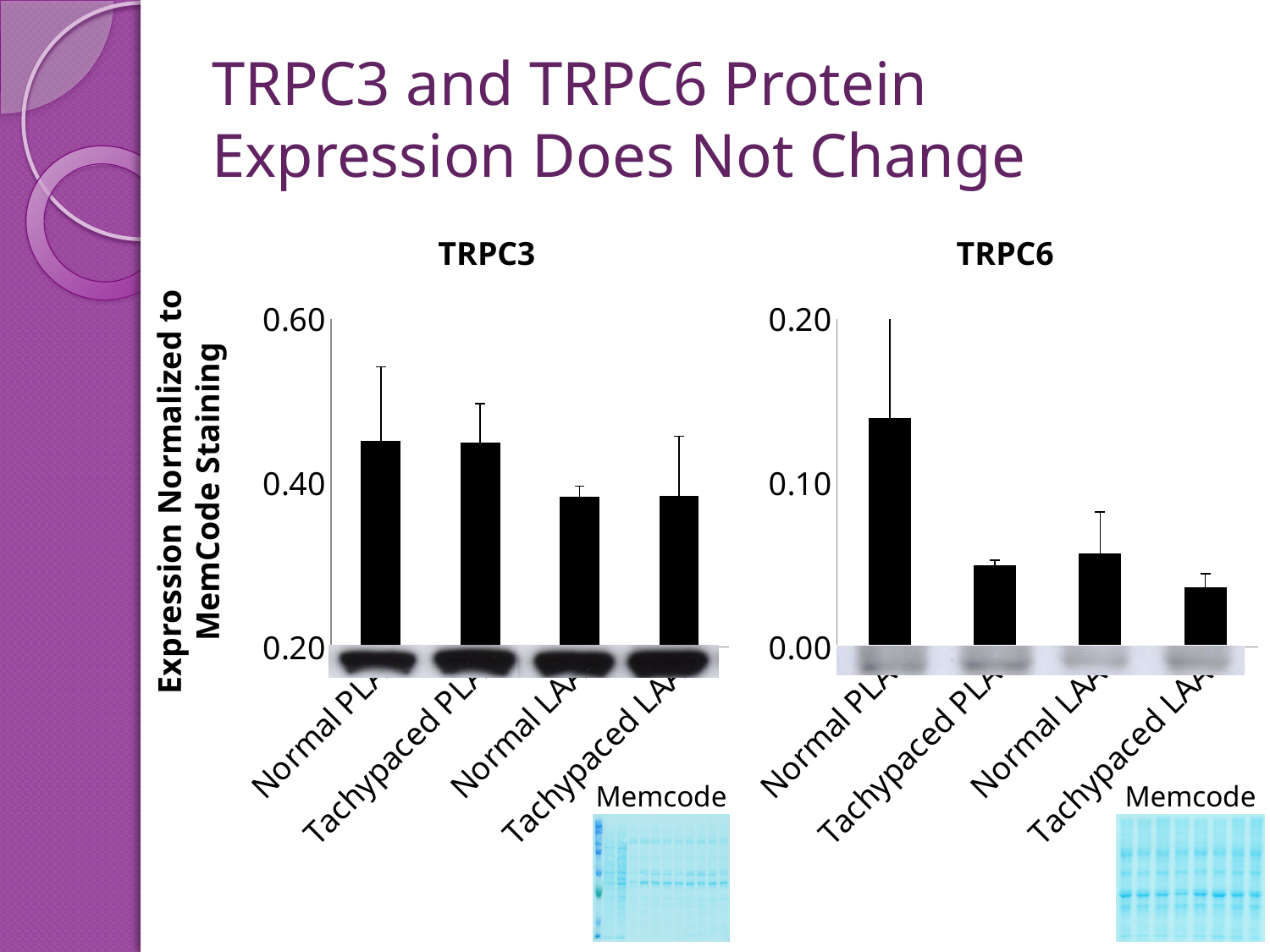
In the TRPC3 chart, is the value for Normal LAA greater or less than 0.40? less In the TRPC6 chart, which is larger, the value for Normal PLA or the value for Tachypaced PLA? Normal PLA What is the title of the chart on the right? TRPC6 In the TRPC3 chart, is the value for Normal PLA greater or less than 0.40? greater In the TRPC6 chart, which category has the highest value? Normal PLA In the TRPC3 chart, which is larger, the value for Tachypaced PLA or the value for Normal LAA? Tachypaced PLA What kind of chart is the TRPC3 chart? bar chart In the TRPC6 chart, is the value for Tachypaced PLA greater or less than 0.10? less What is the y-axis label shared by the two charts? Expression Normalized to MemCode Staining How many categories are shown on the x axis of the TRPC6 chart? 4